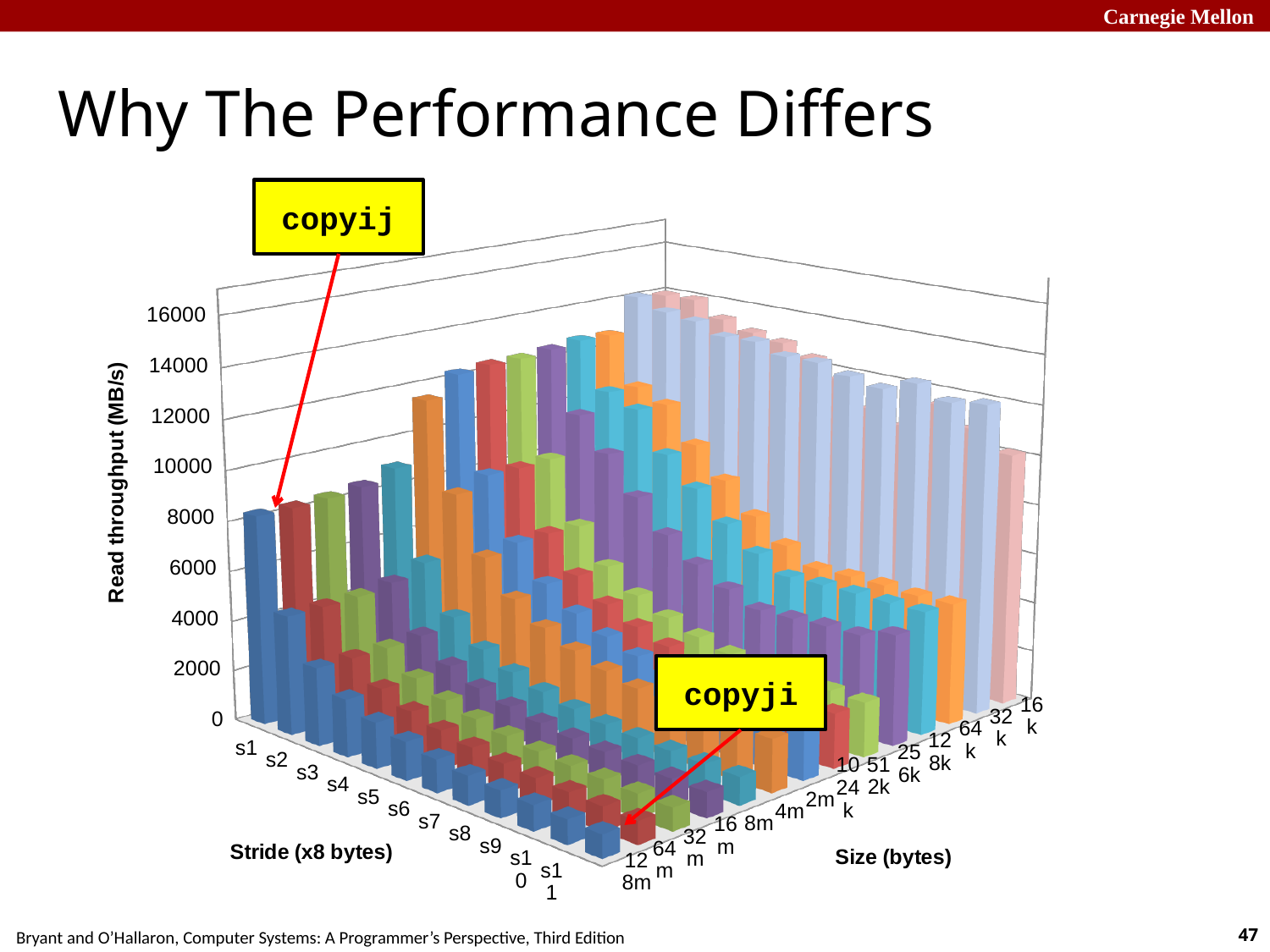
For size 128m, which stride has the highest read throughput? s1 How many stride categories are shown along the Stride (x8 bytes) axis? 11 Is the read throughput for stride s11 at size 128m (the bar labelled copyji) greater or less than 2000? less For stride s1, which is larger: the read throughput at size 16k or at size 128m? 16k For size 128m, which is larger: the read throughput at stride s1 or at stride s11? s1 What is the title of the vertical axis? Read throughput (MB/s) How many size categories are shown along the Size (bytes) axis? 14 What kind of chart is shown on the slide? bar chart Is the read throughput for stride s1 at size 128m greater or less than 4000? greater What are the two labels in the yellow callout boxes on the chart? copyij and copyji Is the read throughput for stride s1 at size 16k greater or less than 12000? greater For size 128m, does read throughput rise or fall as the stride increases from s1 to s11? fall